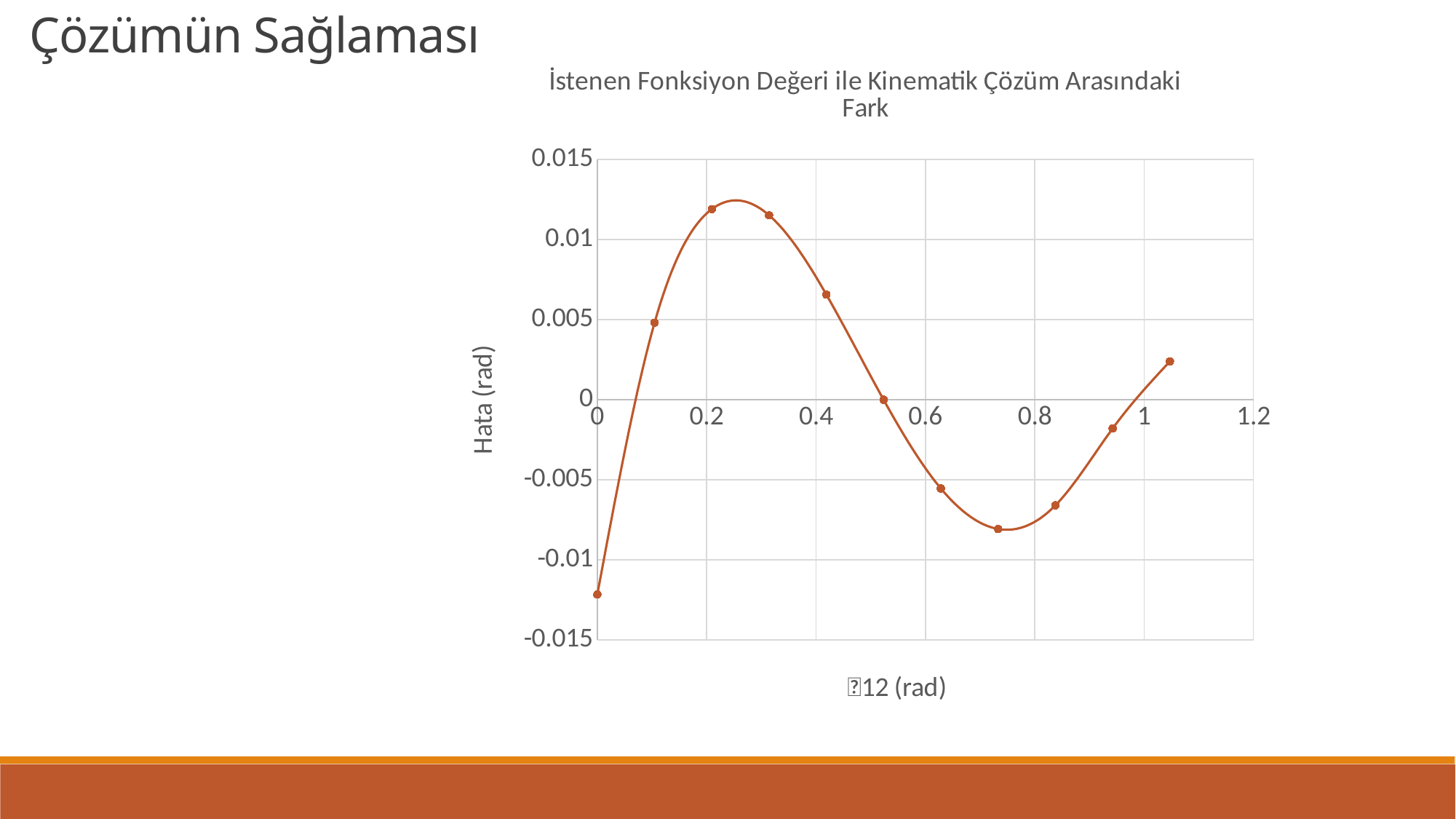
What is the highest value shown on the vertical axis? 0.015 Which is larger: the value at x = 0 or the value at x = 1? the value at x = 1 What is the label of the vertical axis? Hata (rad) Is the value at x = 0 greater or less than -0.01? less Is the lowest point of the line greater or less than -0.015? greater Does the line rise or fall between x = 0.4 and x = 0.7? fall What kind of chart is shown on the slide? line chart At which x-axis tick does the lowest point of the line occur? 0 Does the line rise or fall between x = 0 and x = 0.2? rise What is the title of the chart? İstenen Fonksiyon Değeri ile Kinematik Çözüm Arasındaki Fark Is the highest point of the line greater or less than 0.01? greater How many data points are plotted on the line? 11